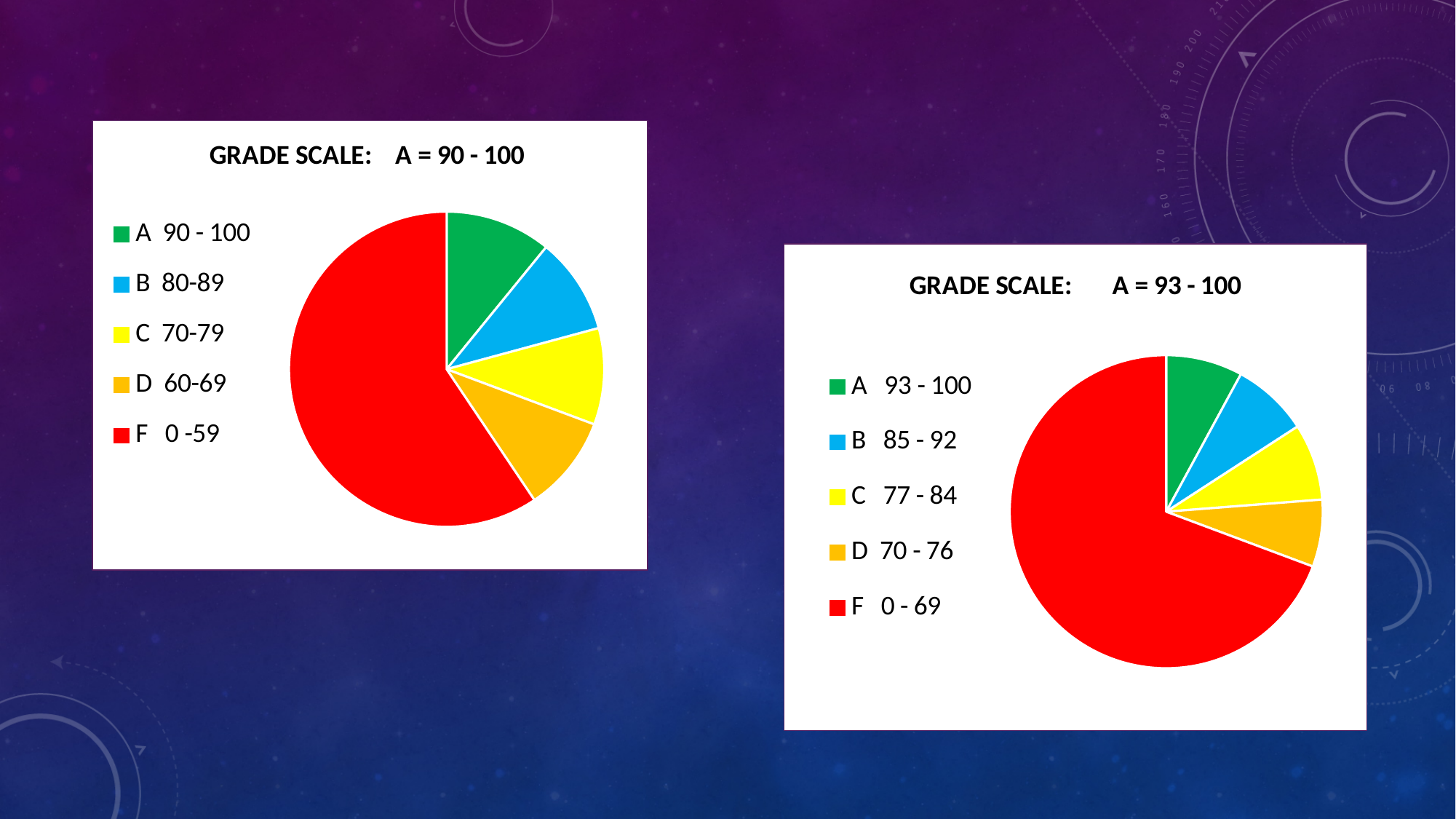
In the chart titled "GRADE SCALE: A = 90 - 100", which grade has the largest slice? F In the chart titled "GRADE SCALE: A = 90 - 100", what colour is the slice for grade F? Red In the chart titled "GRADE SCALE: A = 90 - 100", which slice is larger, F or A? F In the chart titled "GRADE SCALE: A = 93 - 100", which slice is larger, F or D? F In the chart titled "GRADE SCALE: A = 90 - 100", how many slices does the pie have? 5 In the chart titled "GRADE SCALE: A = 90 - 100", which slice is larger, F or C? F In the chart titled "GRADE SCALE: A = 93 - 100", which grade has the largest slice? F In the chart titled "GRADE SCALE: A = 93 - 100", how many entries does the legend list? 5 What kind of chart is the chart titled "GRADE SCALE: A = 93 - 100"? Pie chart What kind of chart is the chart titled "GRADE SCALE: A = 90 - 100"? Pie chart In the chart titled "GRADE SCALE: A = 93 - 100", what score range does the legend give for grade B? 85 - 92